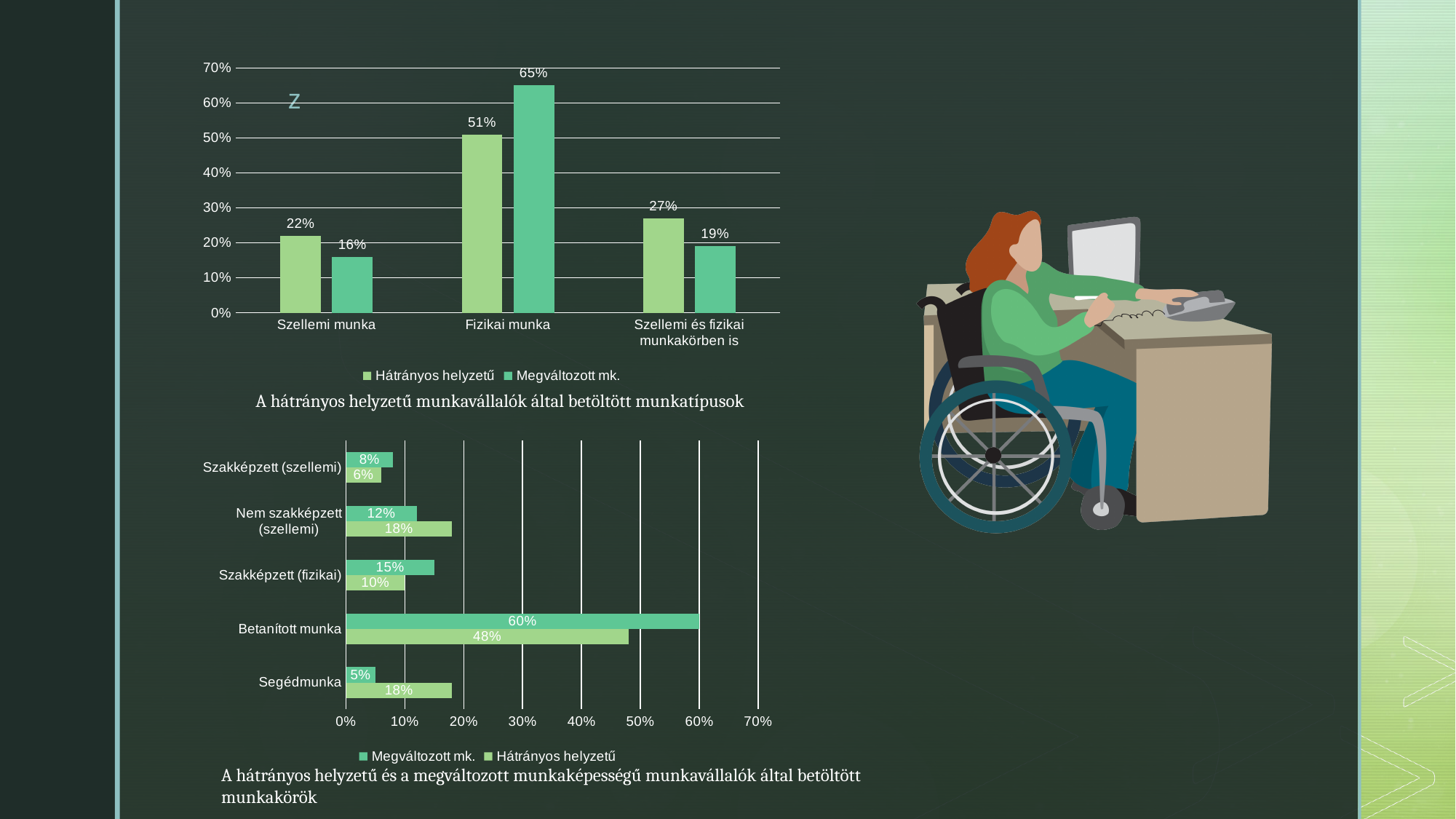
In the top chart, what is the difference between the Megváltozott mk. and Hátrányos helyzetű values for Fizikai munka? 14% In the top chart, which is larger for Szellemi és fizikai munkakörben is: Hátrányos helyzetű or Megváltozott mk.? Hátrányos helyzetű How many series does the legend of the bottom chart list? 2 In the top chart, what is the value for Megváltozott mk. in the Szellemi munka category? 16% In the bottom chart, what is the difference between the Megváltozott mk. and Hátrányos helyzetű values for Betanított munka? 12% What type of chart is the bottom chart? Bar chart In the bottom chart, which category has the lowest value for Megváltozott mk.? Segédmunka In the top chart, which category has the highest value for Megváltozott mk.? Fizikai munka How many categories are shown on the x axis of the top chart? 3 In the bottom chart, what is the value for Hátrányos helyzetű in the Segédmunka category? 18% In the top chart, what is the value for Hátrányos helyzetű in the Fizikai munka category? 51% In the bottom chart, what is the value for Megváltozott mk. in the Betanított munka category? 60%